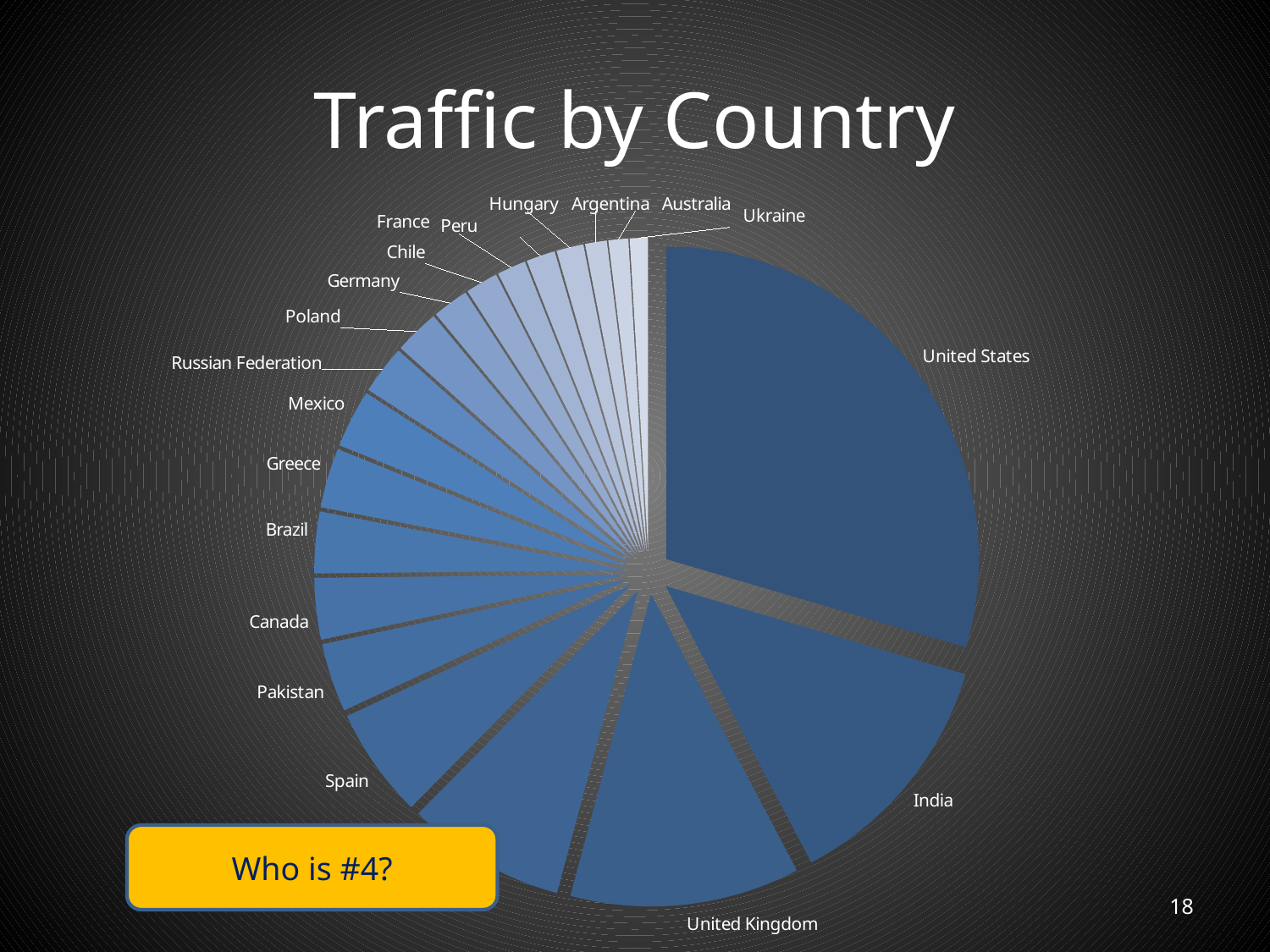
Which country has the smallest slice of the pie? Ukraine Which slice is larger, United States or India? United States What kind of chart is shown on the slide? pie chart Which slice is larger, United Kingdom or Canada? United Kingdom Which slice is larger, Spain or Pakistan? Spain Which country has the second-largest slice of the pie? India How many countries are labelled on the pie chart? 19 Which country has the largest slice of the pie? United States What question is written in the yellow box on the slide? Who is #4? What is the title of the chart? Traffic by Country